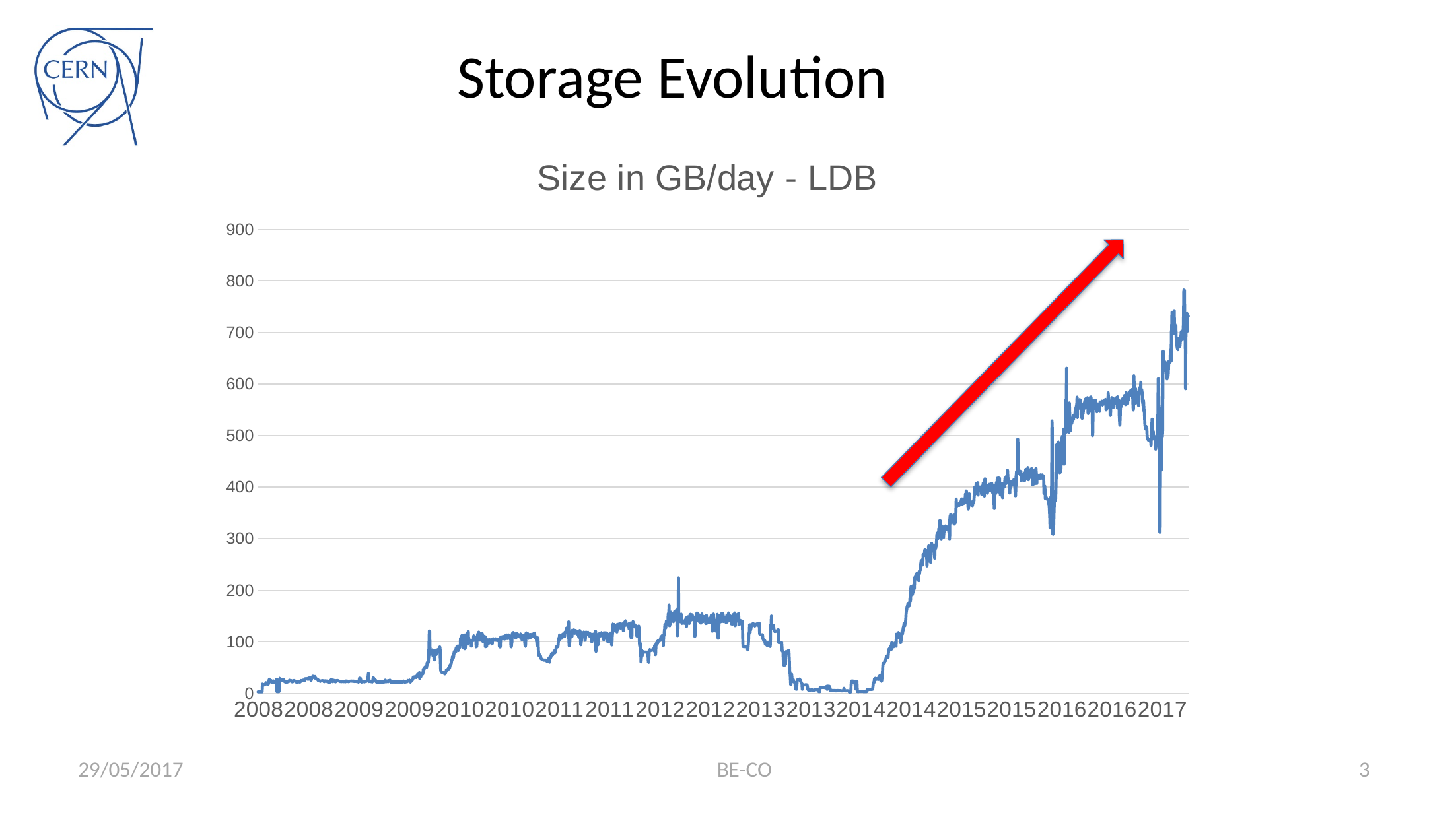
Is the value in 2016 greater or less than 500? greater What kind of chart is shown on the slide? line chart Overall, do the values rise or fall from 2008 to 2017? rise Is the value at the start of 2008 greater or less than 100? less What is the title of the chart? Size in GB/day - LDB Which year has the larger value, 2010 or 2015? 2015 Is the value in 2017 greater or less than 600? greater Which year has the larger value, 2008 or 2017? 2017 What is the highest value shown on the y axis of the chart? 900